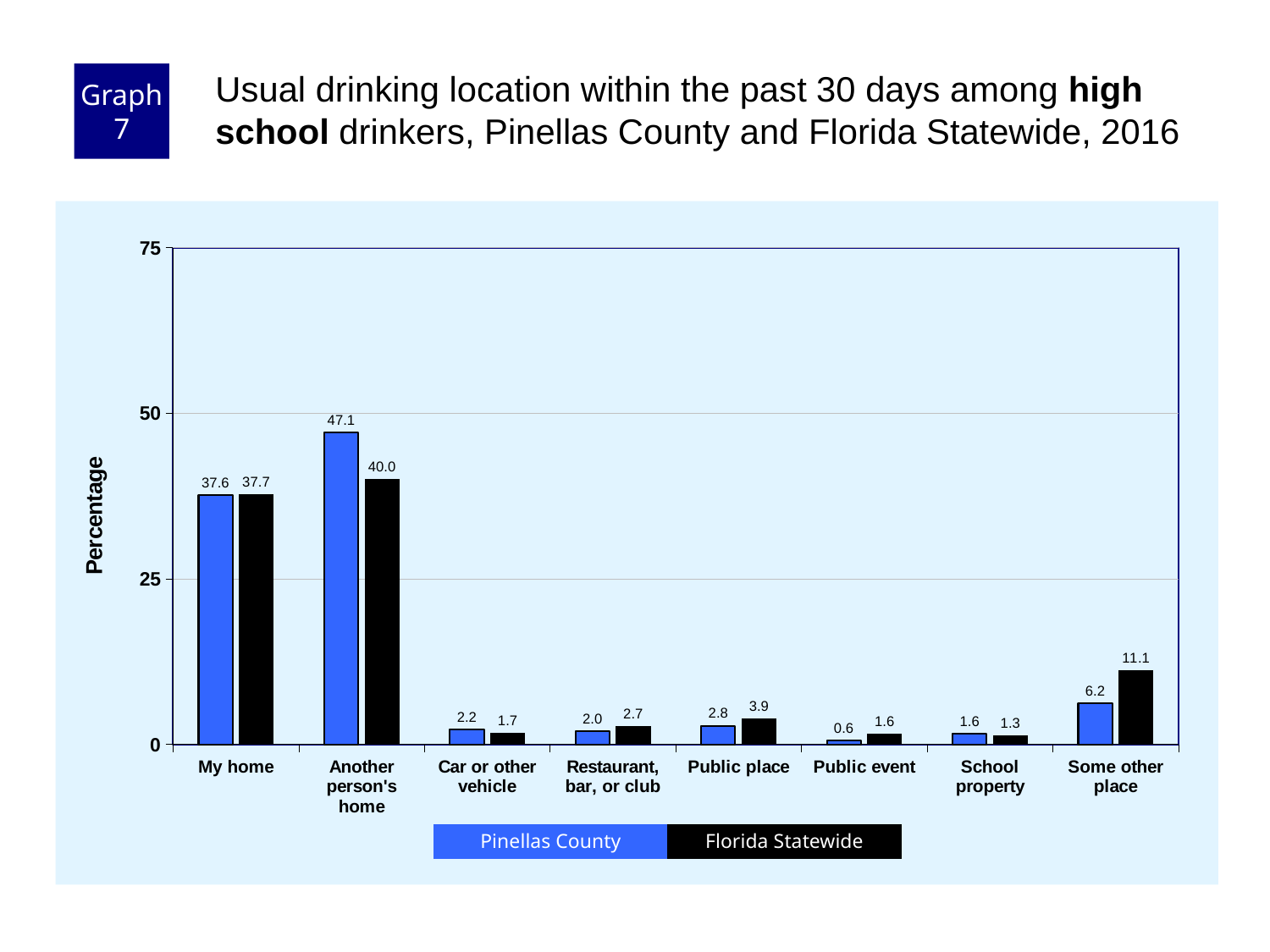
What is the Florida Statewide value for Some other place? 11.1 What is the difference between the Pinellas County and Florida Statewide values for Another person's home? 7.1 What is the Pinellas County value for Public event? 0.6 Which is larger for Public place: Pinellas County or Florida Statewide? Florida Statewide What is the Pinellas County value for Another person's home? 47.1 Which category has the lowest Florida Statewide value? School property What is the label of the y axis? Percentage How many categories are shown on the x axis? 8 Is the Florida Statewide value for My home greater or less than 25? greater What kind of chart is shown? Bar chart How many series does the legend list? 2 Which category has the highest Pinellas County value? Another person's home